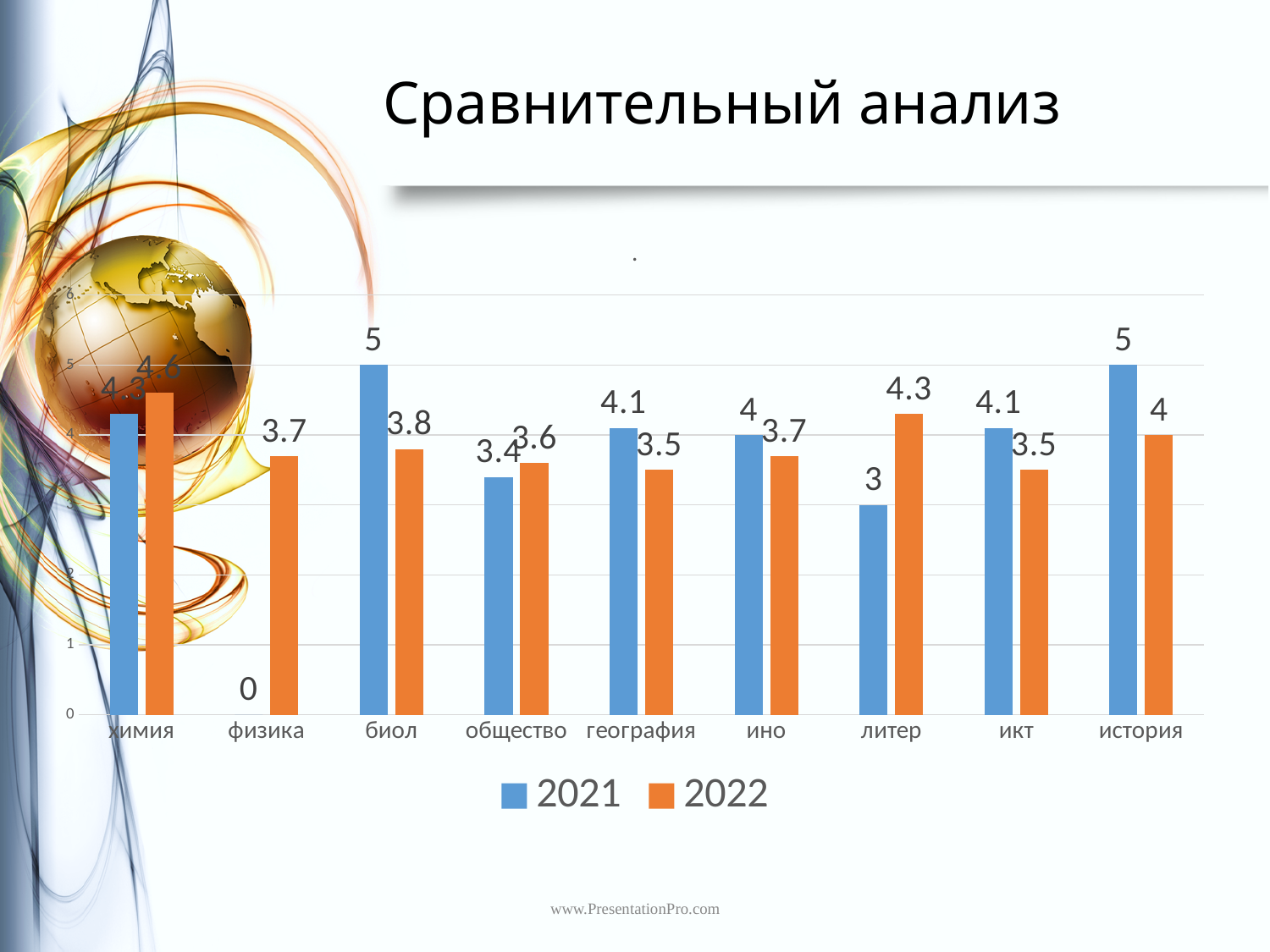
What is the value for физика in the 2021 series? 0 Which category has the highest value in the 2022 series? химия What is the value for история in the 2022 series? 4 What is the difference between the 2021 and 2022 values for биол? 1.2 What is the value for литер in the 2022 series? 4.3 For география, which series has the larger value, 2021 or 2022? 2021 How many series does the legend list? 2 Which category has the lowest value in the 2021 series? физика What is the value for биол in the 2021 series? 5 What is the difference between the 2022 and 2021 values for литер? 1.3 How many categories are shown on the x axis? 9 What kind of chart is shown on the slide? bar chart